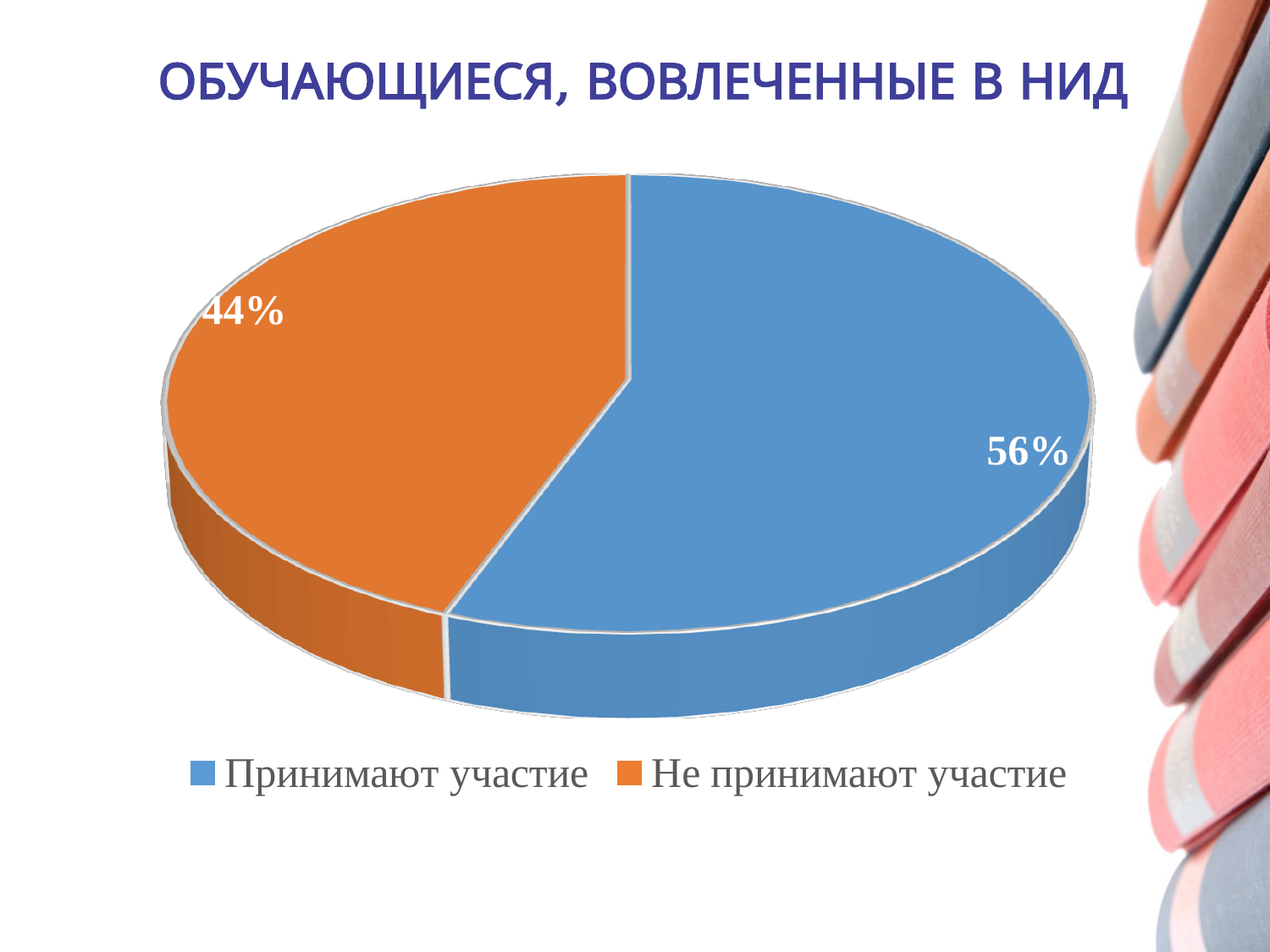
What share of the pie is labelled "Принимают участие"? 56% How many slices does the pie chart have? 2 Which slice is larger: "Принимают участие" or "Не принимают участие"? Принимают участие Which category has the largest slice of the pie? Принимают участие What kind of chart is shown on the slide? Pie chart How many entries does the legend list? 2 What is the difference in percentage points between the "Принимают участие" and "Не принимают участие" slices? 12 What is the title of the chart on the slide? ОБУЧАЮЩИЕСЯ, ВОВЛЕЧЕННЫЕ В НИД What share of the pie is labelled "Не принимают участие"? 44% What colour is the "Не принимают участие" slice? Orange Which category has the smallest slice of the pie? Не принимают участие